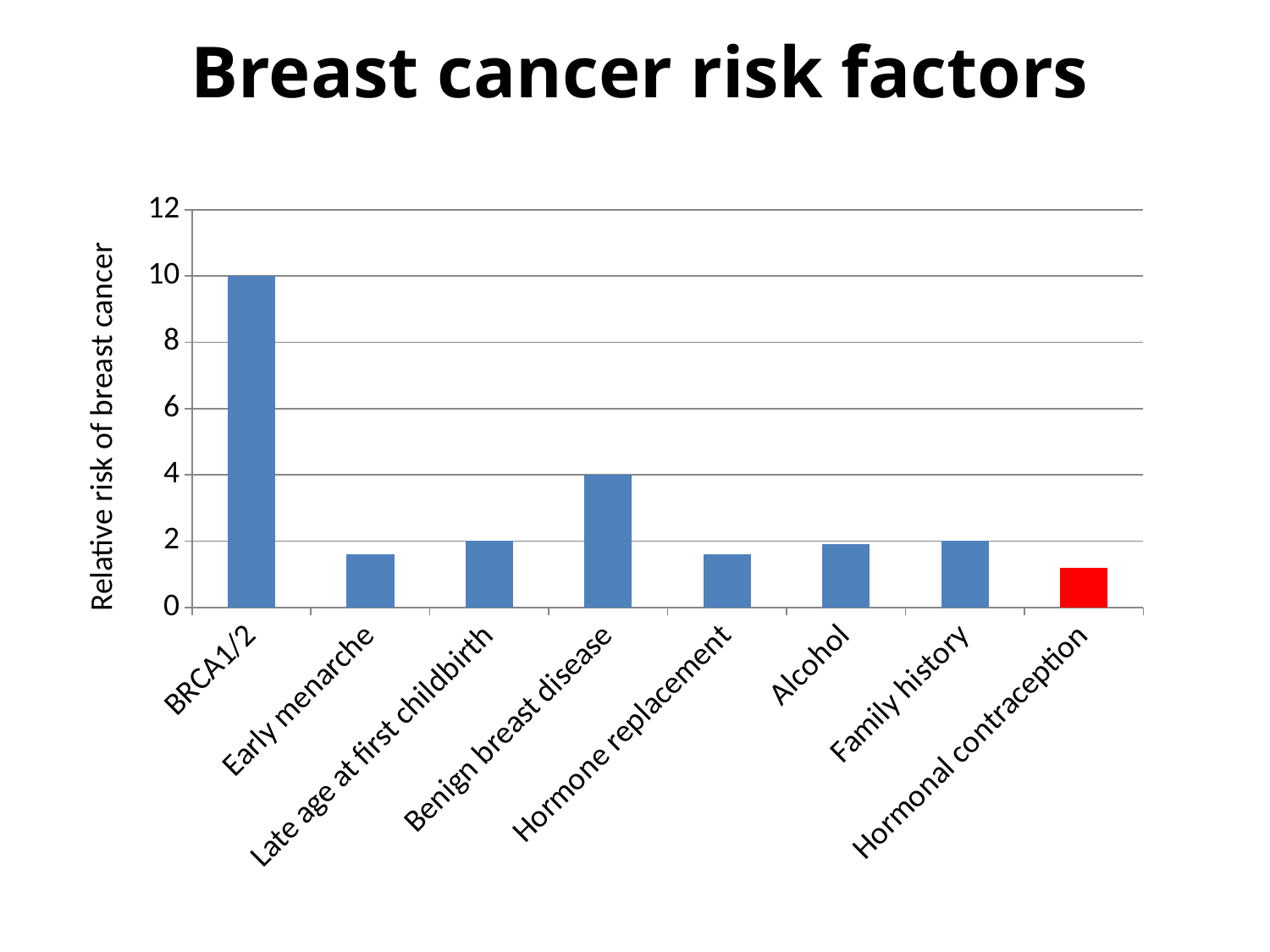
What type of chart is shown on the slide? Bar chart What is the relative risk of breast cancer for Family history? 2 Which has a higher relative risk, Benign breast disease or Late age at first childbirth? Benign breast disease What is the label on the vertical axis of the chart? Relative risk of breast cancer How many risk factors (categories) are plotted on the chart? 8 What is the difference in relative risk between BRCA1/2 and Benign breast disease? 6 Is the value for Hormone replacement greater or less than 2? less Which risk factor is shown with a red bar? Hormonal contraception Which risk factor has the lowest relative risk of breast cancer? Hormonal contraception Which risk factor has the highest relative risk of breast cancer? BRCA1/2 What is the relative risk of breast cancer for BRCA1/2? 10 What is the relative risk of breast cancer for Benign breast disease? 4